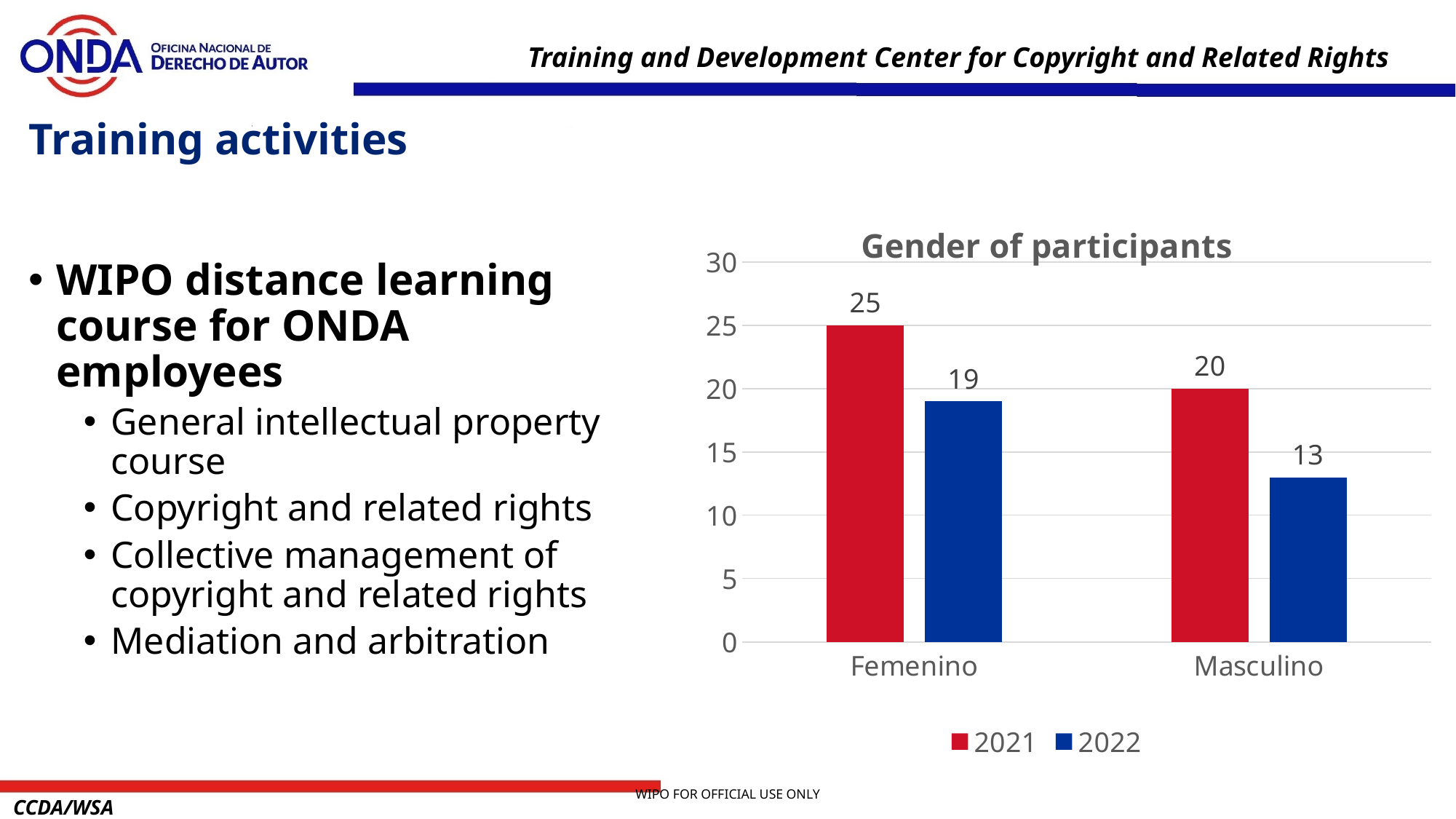
Which category has the highest value in the 2021 series? Femenino What is the title of the chart? Gender of participants Which is larger: Femenino in 2022 or Masculino in 2021? Masculino in 2021 Which category has the lowest value in the 2022 series? Masculino How many categories are shown on the x axis? 2 What is the difference between the Masculino values for 2021 and 2022? 7 What is the value for Masculino in 2021? 20 What is the value for Masculino in 2022? 13 What is the value for Femenino in 2022? 19 What is the value for Femenino in 2021? 25 How many series does the legend list? 2 What is the difference between the Femenino values for 2021 and 2022? 6